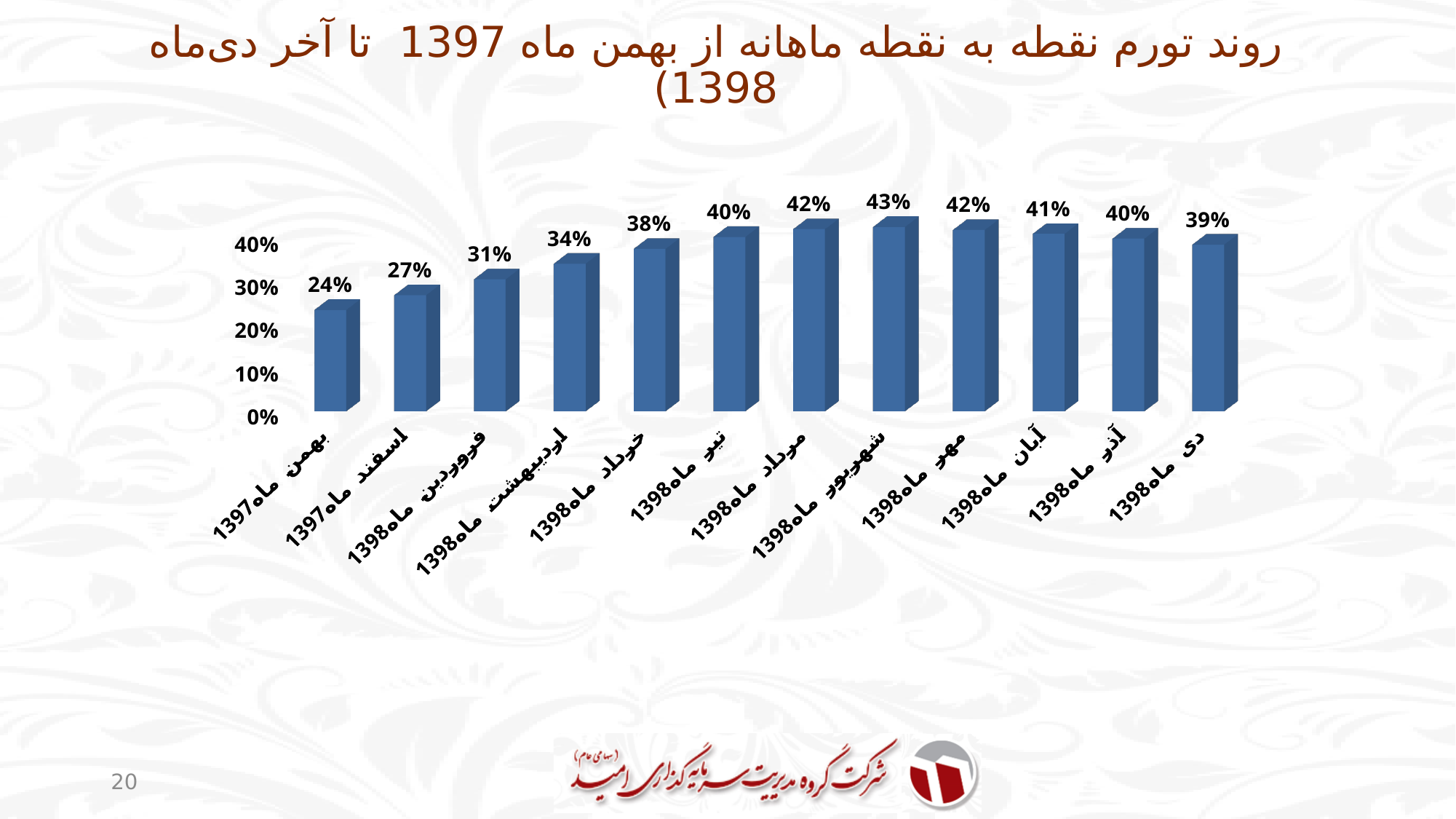
What kind of chart is shown on the slide? Bar chart How many months are shown on the chart? 12 Which is larger, the value for خرداد ماه 1398 or the value for آذر ماه 1398? آذر ماه 1398 What is the value for دی ماه 1398? 39% What is the difference between the values for شهریور ماه 1398 and بهمن ماه 1397? 19% Which month has the lowest value? بهمن ماه 1397 What is the value for بهمن ماه 1397? 24% What is the value for شهریور ماه 1398? 43% Which month has the highest value? شهریور ماه 1398 Do the values rise or fall from شهریور ماه 1398 to دی ماه 1398? Fall Do the values rise or fall from بهمن ماه 1397 to شهریور ماه 1398? Rise What is the difference between the values for فروردین ماه 1398 and اسفند ماه 1397? 4%